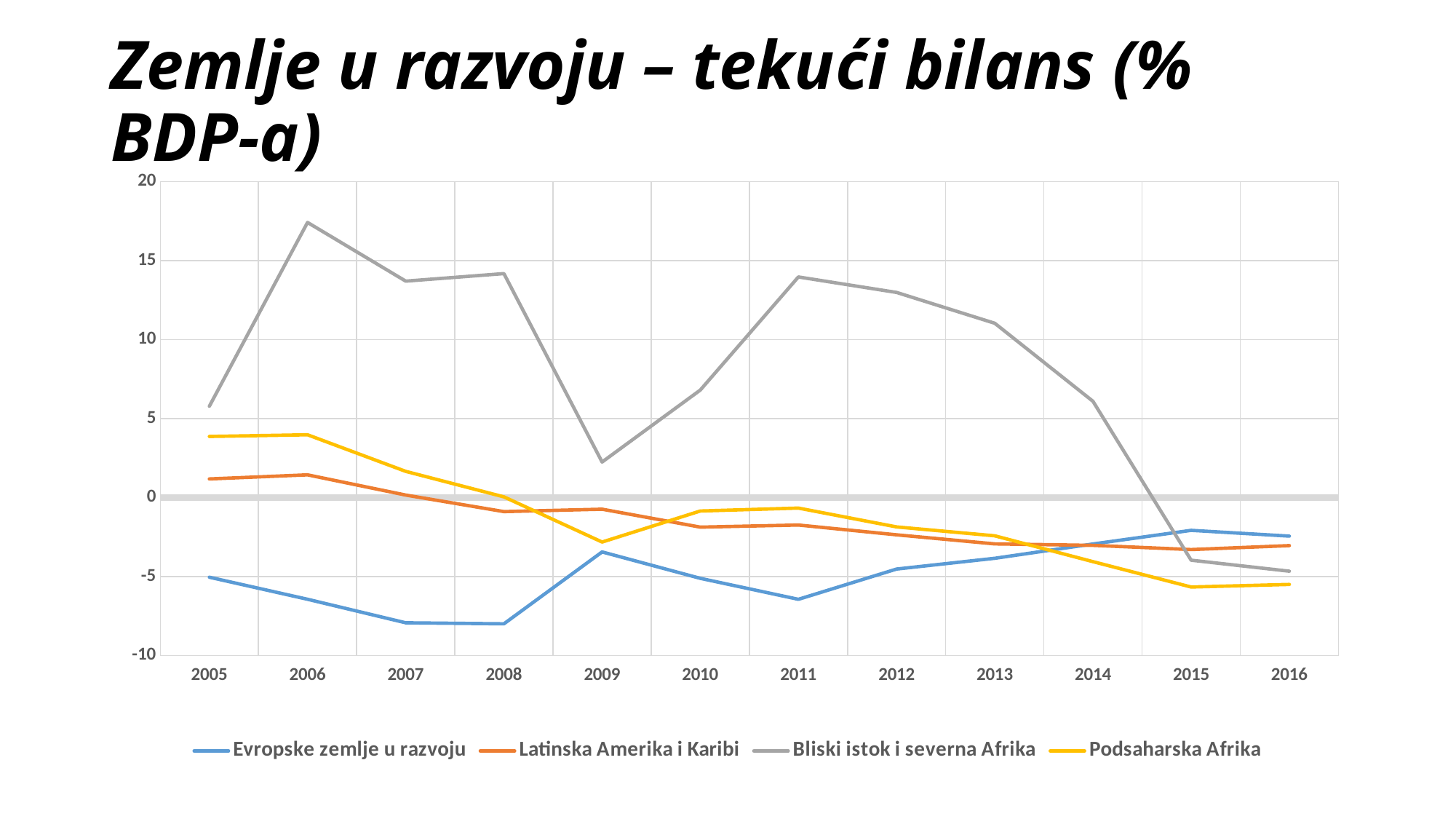
Which series has the lowest value in 2007? Evropske zemlje u razvoju How many years are shown on the x axis? 12 Which series has the highest value in 2006? Bliski istok i severna Afrika Is the value for Bliski istok i severna Afrika in 2006 greater or less than 15? greater How many series does the legend list? 4 What kind of chart is shown on the slide? line chart In 2005, which is higher: Podsaharska Afrika or Latinska Amerika i Karibi? Podsaharska Afrika What is the title of the slide? Zemlje u razvoju – tekući bilans (% BDP-a) Is the value for Evropske zemlje u razvoju in 2007 greater or less than -5? less Does the value for Bliski istok i severna Afrika rise or fall from 2011 to 2015? fall Is the value for Bliski istok i severna Afrika in 2009 greater or less than 5? less In which year does Bliski istok i severna Afrika reach its highest value? 2006